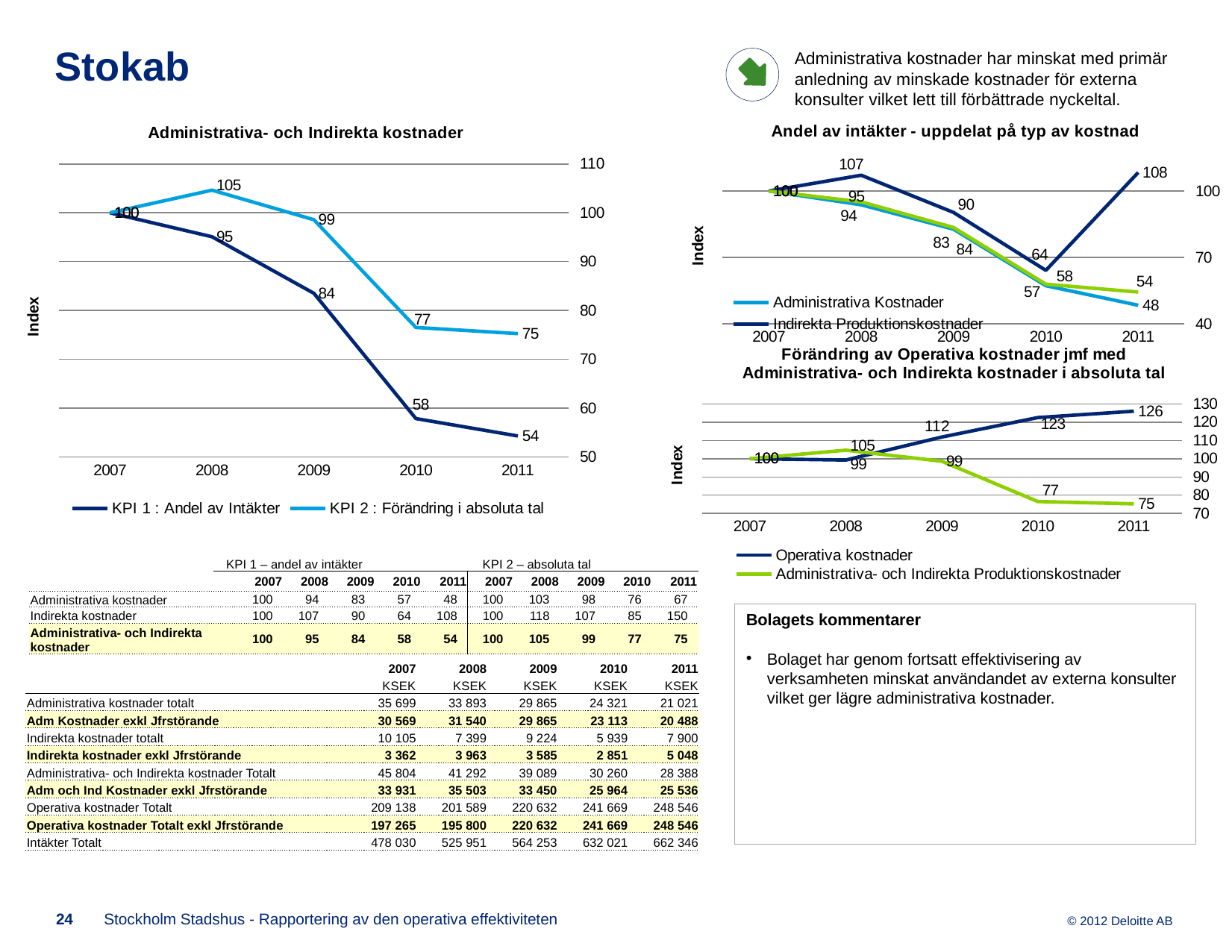
In the bottom-right chart 'Förändring av Operativa kostnader jmf med Administrativa- och Indirekta kostnader i absoluta tal', how many years are shown on the x axis? 5 What kind of chart is 'Andel av intäkter - uppdelat på typ av kostnad'? line chart In the bottom-right chart 'Förändring av Operativa kostnader jmf med Administrativa- och Indirekta kostnader i absoluta tal', what is the value of Operativa kostnader in 2010? 123 In the chart titled 'Administrativa- och Indirekta kostnader', does KPI 1 : Andel av Intäkter rise or fall from 2007 to 2011? fall In the chart titled 'Administrativa- och Indirekta kostnader', what is the difference between KPI 2 and KPI 1 in 2011? 21 In the chart titled 'Administrativa- och Indirekta kostnader', in which year is KPI 1 : Andel av Intäkter lowest? 2011 In the chart titled 'Administrativa- och Indirekta kostnader', what is the value of KPI 2 : Förändring i absoluta tal in 2008? 105 In the chart titled 'Andel av intäkter - uppdelat på typ av kostnad', what is the value of Indirekta Produktionskostnader in 2011? 108 In the chart titled 'Administrativa- och Indirekta kostnader', what is the value of KPI 1 : Andel av Intäkter in 2010? 58 In the chart titled 'Administrativa- och Indirekta kostnader', how many series does the legend list? 2 In the chart titled 'Andel av intäkter - uppdelat på typ av kostnad', what is the value of Administrativa Kostnader in 2011? 48 In the chart titled 'Andel av intäkter - uppdelat på typ av kostnad', which is larger in 2010: Administrativa Kostnader or Indirekta Produktionskostnader? Indirekta Produktionskostnader